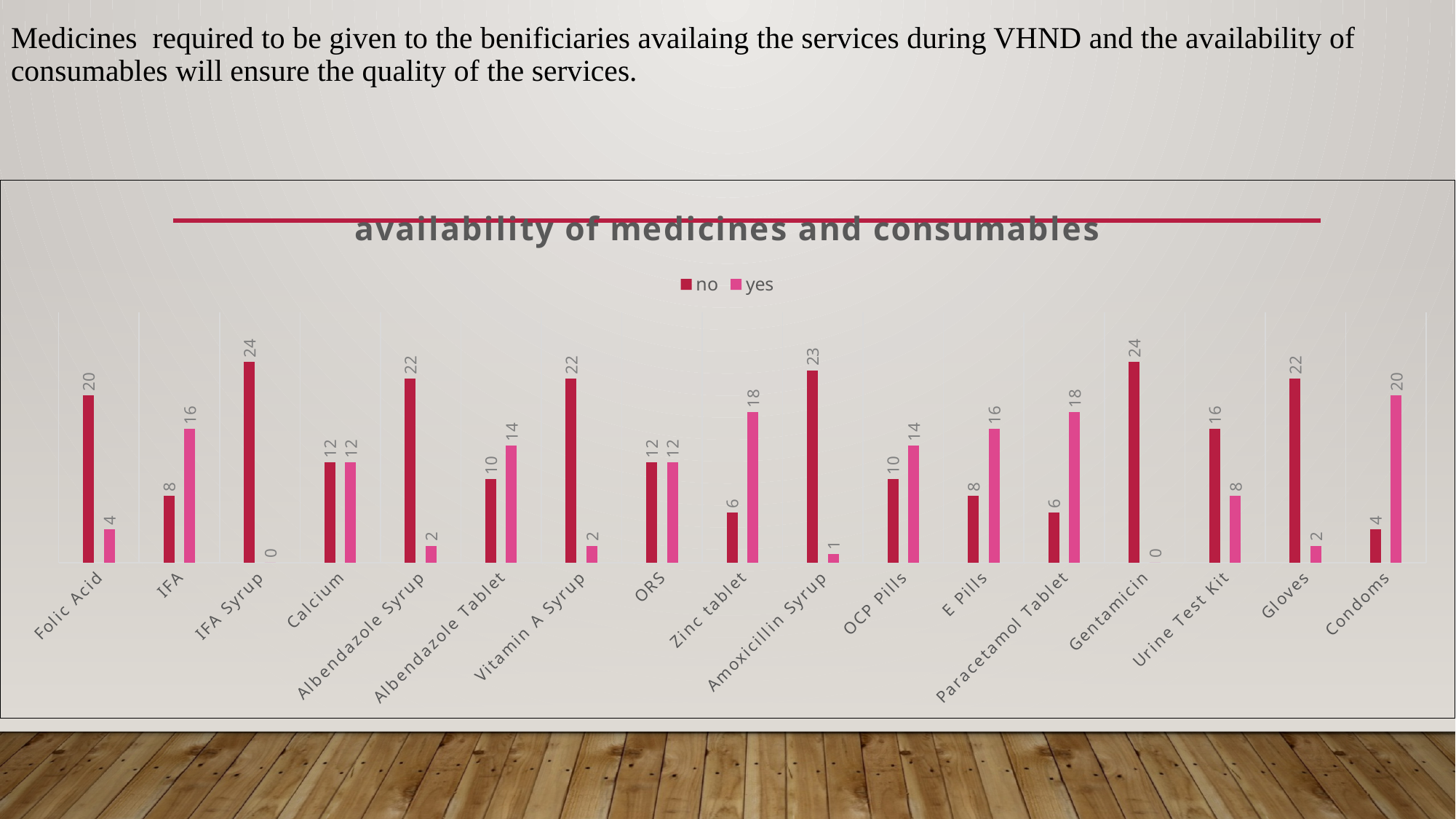
What is the 'no' value for Folic Acid? 20 For Paracetamol Tablet, which is larger, the 'no' value or the 'yes' value? yes What is the title of the chart? availability of medicines and consumables What is the difference between the 'no' and 'yes' values for Urine Test Kit? 8 Which category has the lowest 'no' value? Condoms How many categories are shown on the x axis? 17 What is the 'yes' value for Gentamicin? 0 What is the 'no' value for Amoxicillin Syrup? 23 What is the 'yes' value for Zinc tablet? 18 What kind of chart is shown? bar chart How many series does the legend list? 2 Which category has the highest 'yes' value? Condoms